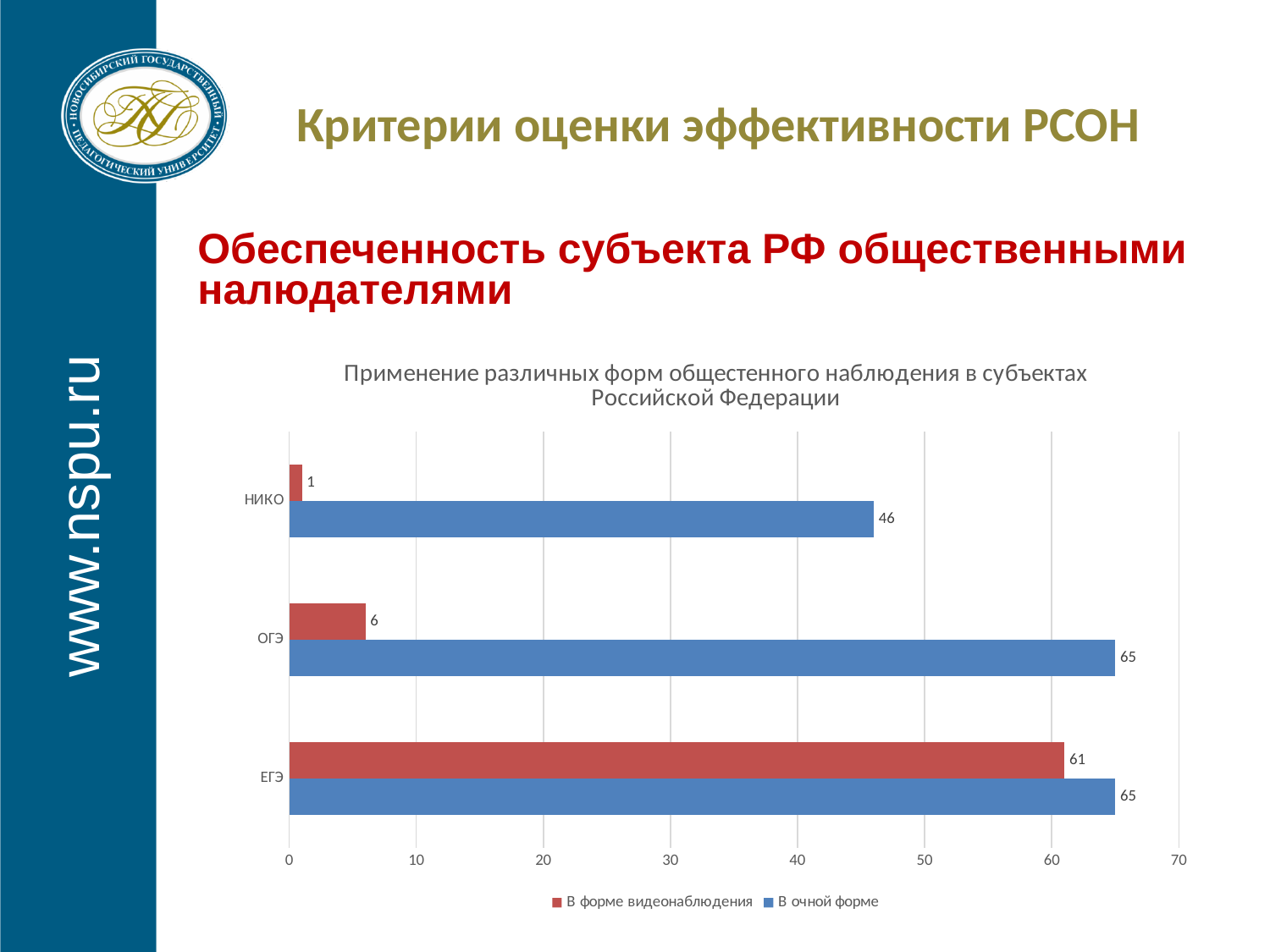
Which category has the lowest value in the series 'В очной форме'? НИКО What kind of chart is shown on the slide? Bar chart Which is larger for ОГЭ: the 'В очной форме' value or the 'В форме видеонаблюдения' value? В очной форме What is the value for ОГЭ in the series 'В форме видеонаблюдения'? 6 What is the value for ЕГЭ in the series 'В очной форме'? 65 How many series does the legend list? 2 What is the difference between the 'В очной форме' values for ОГЭ and НИКО? 19 What is the difference between the 'В очной форме' and 'В форме видеонаблюдения' values for ЕГЭ? 4 Which category has the highest value in the series 'В форме видеонаблюдения'? ЕГЭ What is the value for НИКО in the series 'В форме видеонаблюдения'? 1 How many categories are shown on the chart? 3 What colour are the bars for the series 'В форме видеонаблюдения'? Red